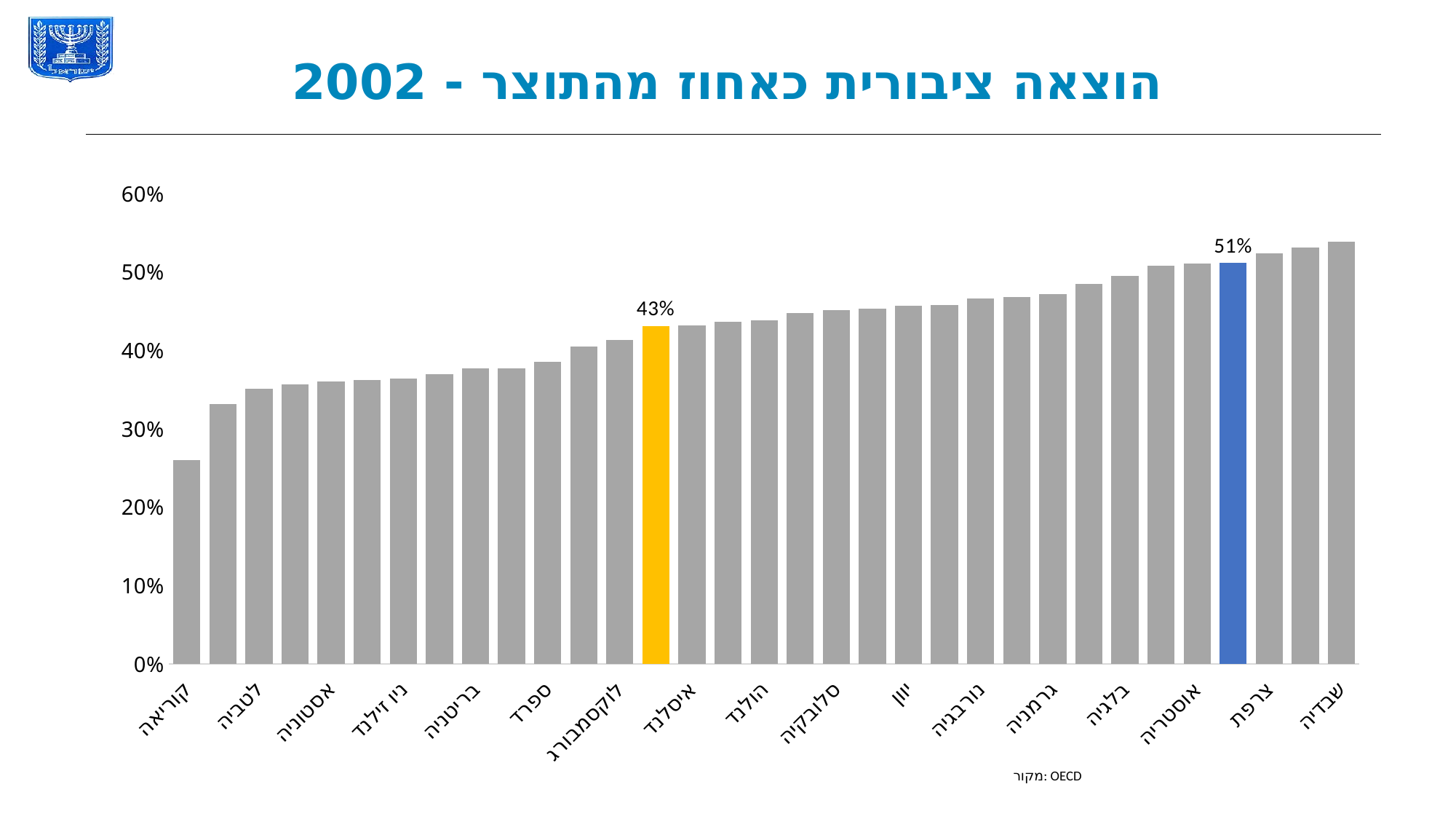
Is the value for קוריאה greater or less than 30%? less What value is labelled on the blue (highlighted) bar? 51% What kind of chart is shown on the slide? Bar chart Which country has the highest public expenditure as a share of GDP in the chart? שבדיה Which country has the lowest public expenditure as a share of GDP in the chart? קוריאה Which is larger, the value for צרפת or the value for קוריאה? צרפת Do the bar values rise or fall from left to right across the chart? Rise What is the title of the chart on the slide? הוצאה ציבורית כאחוז מהתוצר - 2002 Is the value for הולנד greater or less than 40%? greater What is the difference between the blue bar's value and the yellow bar's value? 8 percentage points Is the value for שבדיה greater or less than 50%? greater What value is labelled on the yellow (highlighted) bar? 43%